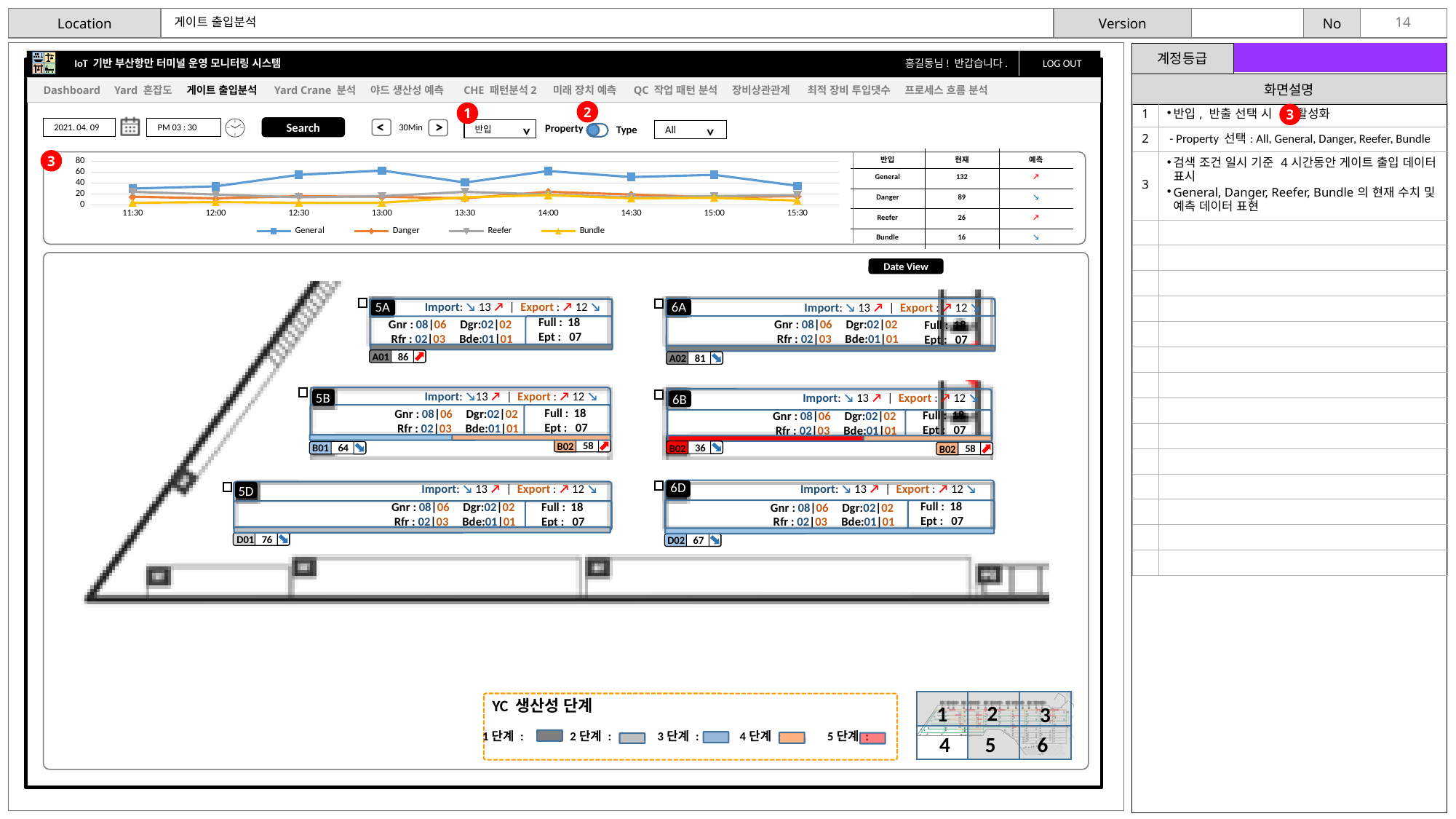
At 13:00, which is larger: the General value or the Bundle value? General How many time points are shown along the x axis of the line chart? 9 Is the value for General at 11:30 greater or less than 40? less What are the series names listed in the legend of the line chart? General, Danger, Reefer, Bundle Which series has the highest values across the line chart? General Is the value for General at 14:00 greater or less than 40? greater How many series does the legend of the line chart list? 4 Is the value for General at 13:00 greater or less than 40? greater Does the General line rise or fall from 12:00 to 13:00? rise What colour is the General series line in the chart? blue What kind of chart is shown at the top of the slide? line chart